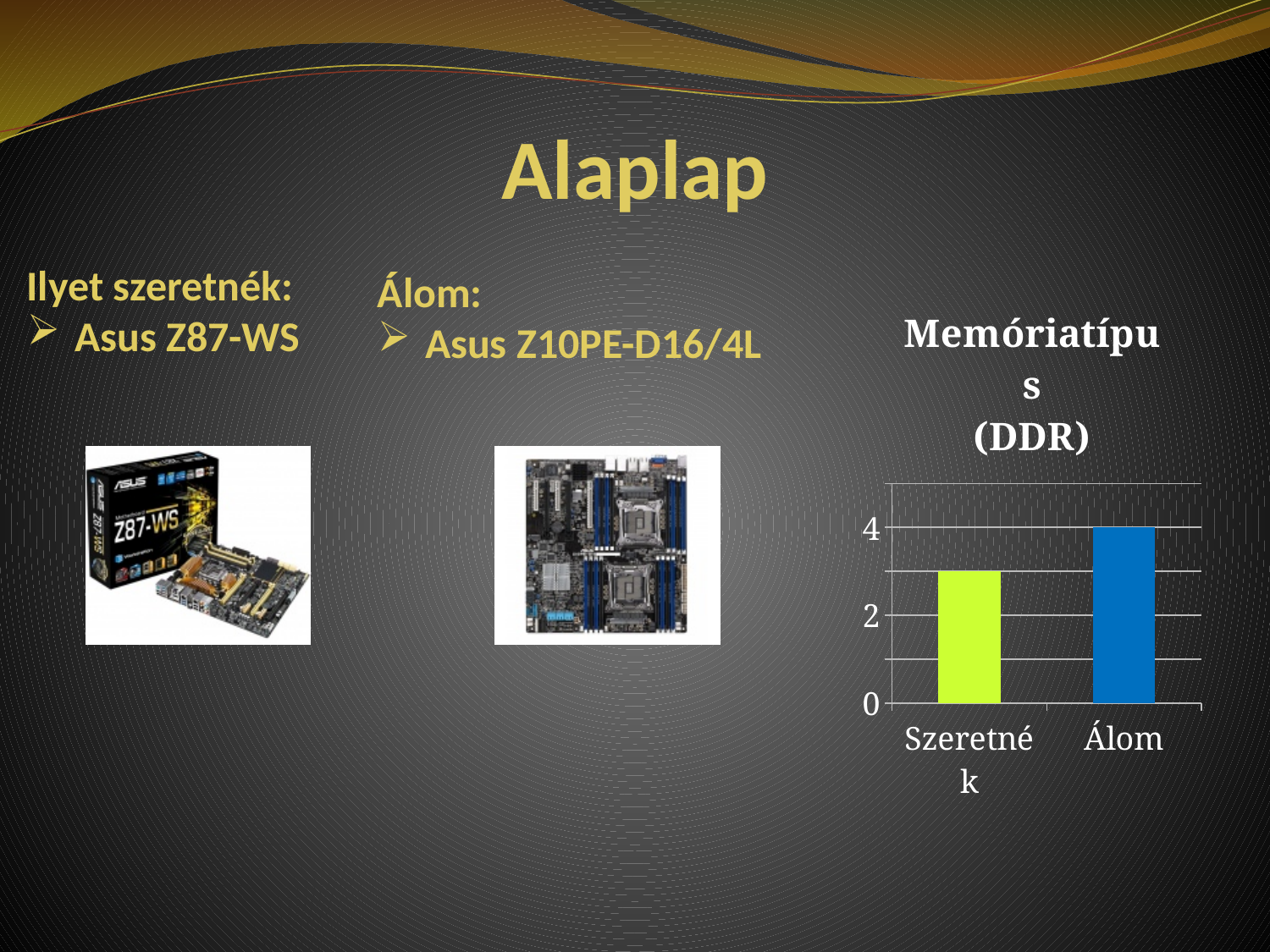
Do the values rise or fall from Szeretnék to Álom along the x axis? rise How many categories are plotted in the chart? 2 Is the value for Szeretnék greater or less than 2? greater Which category has the highest value in the chart? Álom What colour is the bar for Álom? blue Which is larger, the value for Szeretnék or the value for Álom? Álom Is the value for Szeretnék greater or less than 4? less Which category has the lowest value in the chart? Szeretnék What kind of chart is shown on the slide? bar chart What is the title of the chart on the slide? Memóriatípus (DDR) What is the value for Álom in the chart? 4